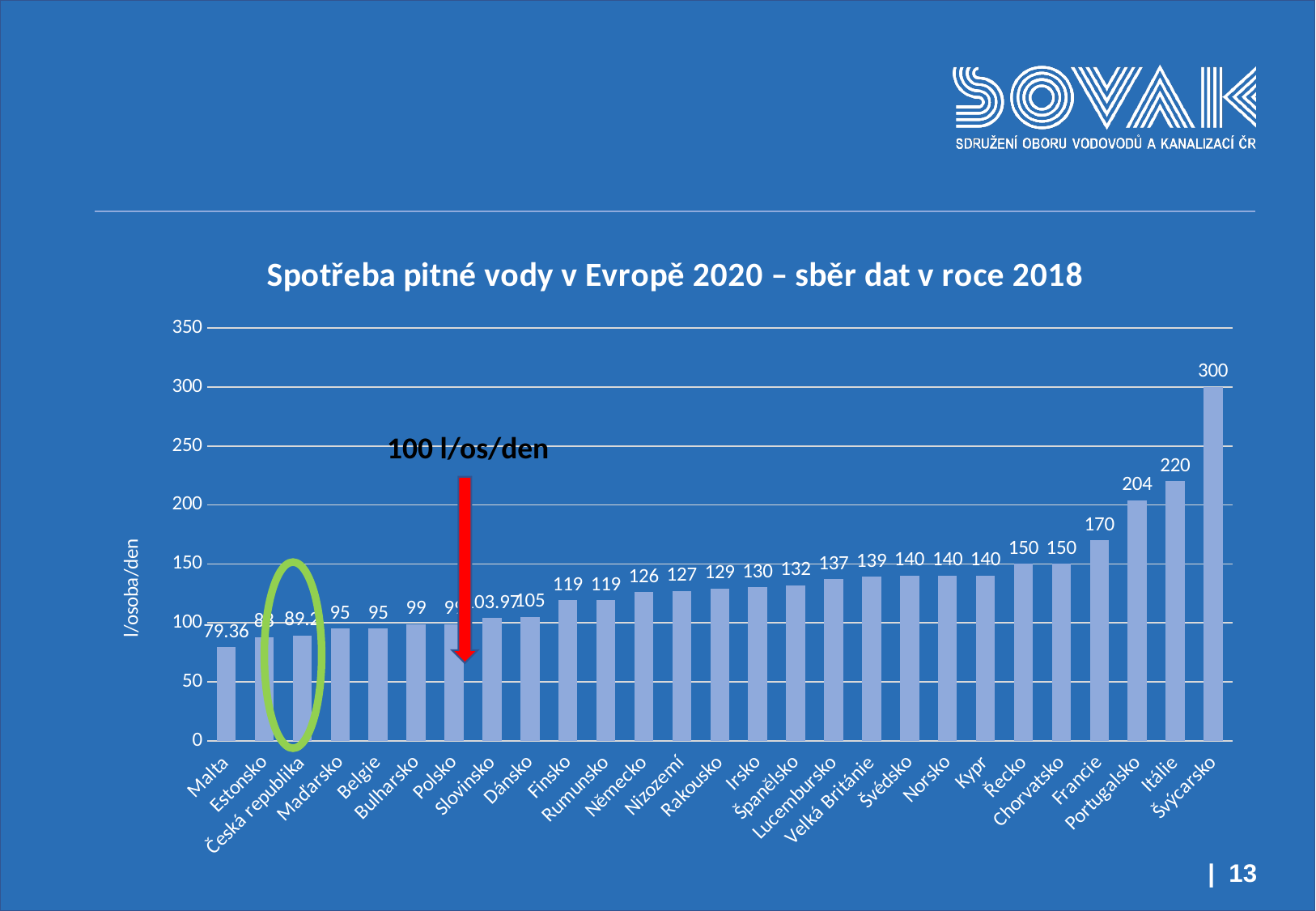
Which has the larger value, Německo or Rakousko? Rakousko What kind of chart is shown on the slide? bar chart What is the value for Malta? 79.36 What is the value for Francie? 170 Which country has the highest value in the chart? Švýcarsko What is the label on the vertical axis of the chart? l/osoba/den What is the value for Švýcarsko? 300 What is the difference between the values for Itálie and Portugalsko? 16 What is the difference between the values for Švýcarsko and Itálie? 80 What is the value for Lucembursko? 137 How many countries are shown in the chart? 27 Which country has the lowest value in the chart? Malta